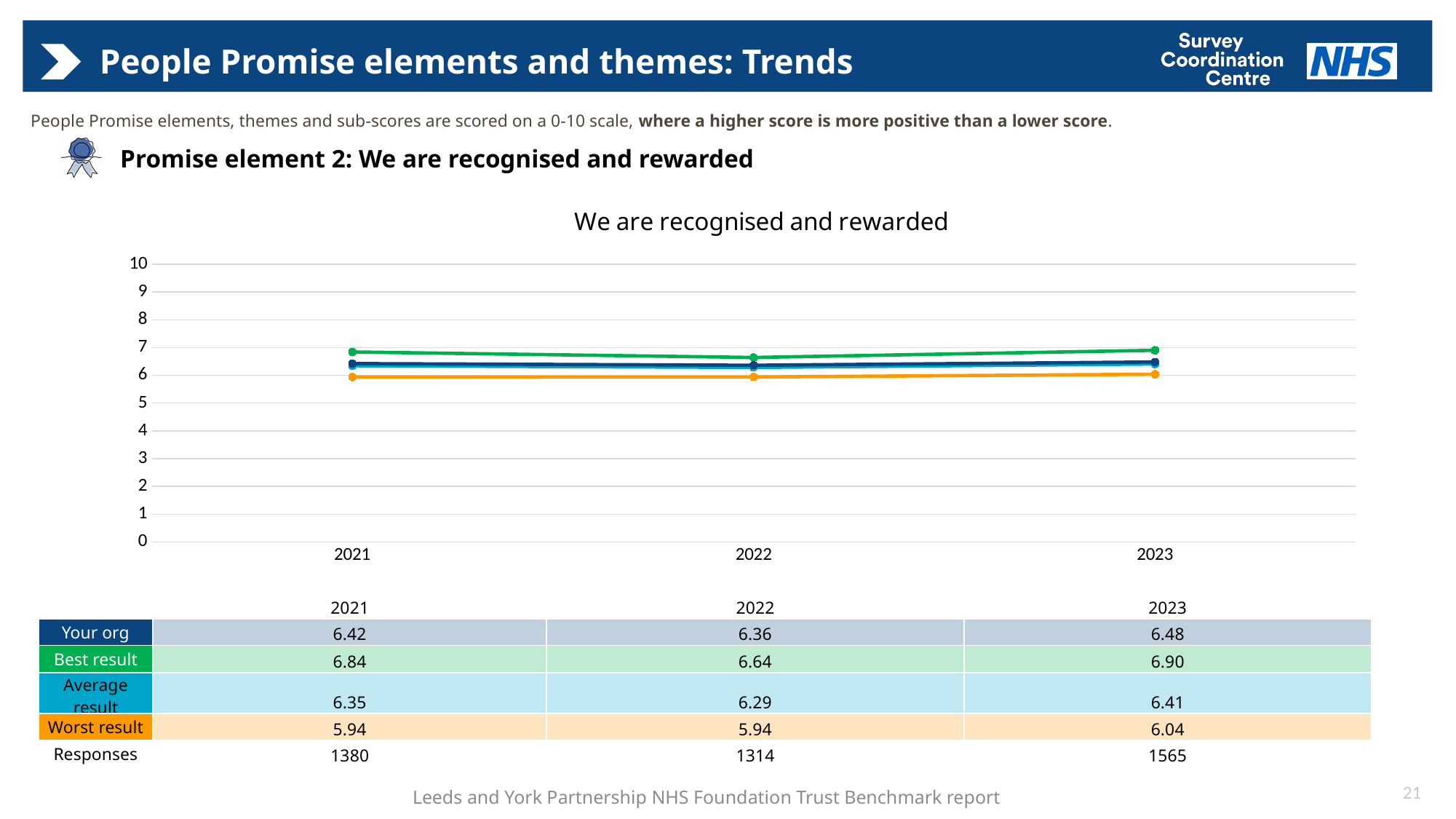
What is the 'Best result' score for 2023? 6.90 What is the 'Worst result' score for 2021? 5.94 What is the difference between the 'Best result' and 'Worst result' scores in 2023? 0.86 What is the title of the chart? We are recognised and rewarded What is the 'Average result' score for 2023? 6.41 In which year is the 'Best result' score lowest? 2022 How many years are shown on the x axis? 3 What is the 'Your org' score for 2022? 6.36 How many series are plotted on the chart? 4 In which year is the 'Your org' score highest? 2023 Which is larger in 2021, the 'Your org' score or the 'Average result' score? Your org What type of chart is shown on the slide? line chart